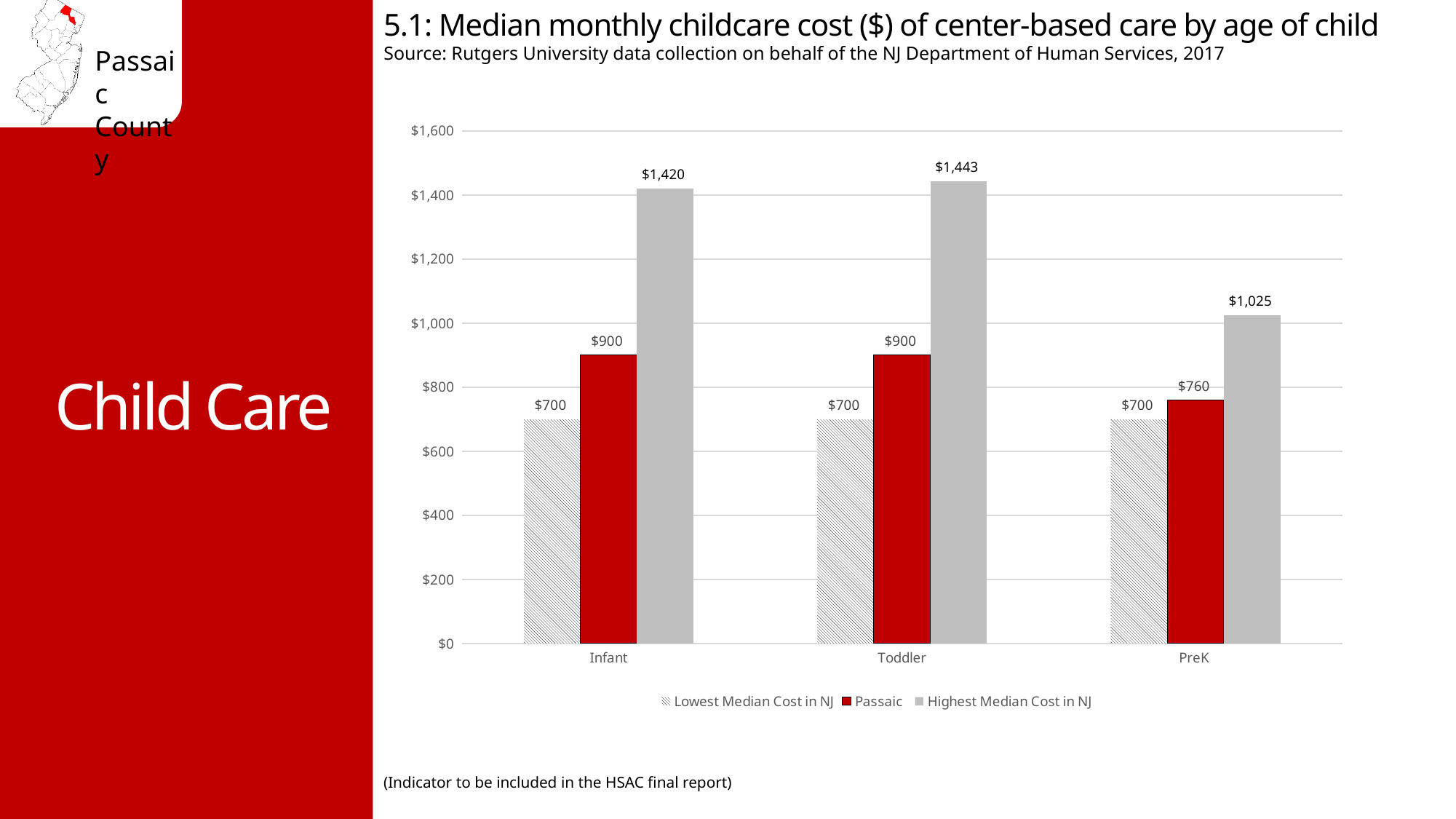
What kind of chart is shown on the slide? Bar chart Is the Highest Median Cost in NJ for PreK care greater or less than $1,200? less What is the difference between the Highest Median Cost in NJ and the Passaic cost for Infant care? $520 What is the Highest Median Cost in NJ for Toddler care? $1,443 What is the Passaic median monthly childcare cost for Infant care? $900 What is the Lowest Median Cost in NJ for PreK care? $700 Which age group has the lowest Passaic median monthly cost? PreK Which is larger: the Passaic cost for Toddler care or the Passaic cost for PreK care? Toddler Which age group has the highest value for the Highest Median Cost in NJ series? Toddler How many series does the legend list? 3 How many age groups are shown on the x axis? 3 What is the Passaic median monthly cost for PreK care? $760